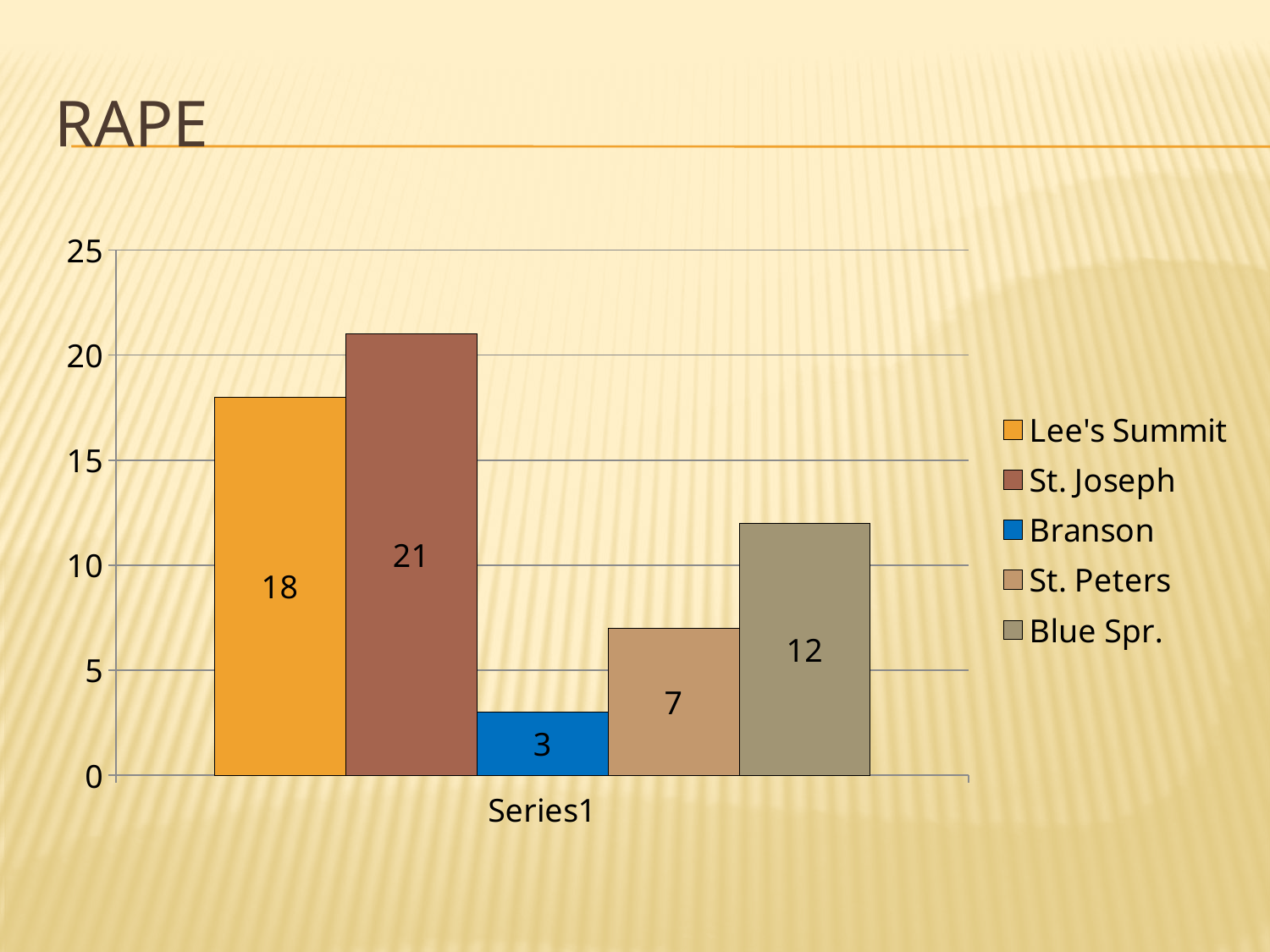
What is the value for Branson? 3 How many bars are shown in the chart? 5 Which is larger, the value for Lee's Summit or the value for Blue Spr.? Lee's Summit What is the difference between the values for St. Joseph and Lee's Summit? 3 Is the value for St. Peters greater or less than 10? less Which city has the lowest value? Branson Which city has the highest value? St. Joseph What is the value for Blue Spr.? 12 What kind of chart is shown on the slide? bar chart What is the value for St. Joseph? 21 What is the title of the slide? RAPE What is the difference between the values for Blue Spr. and St. Peters? 5